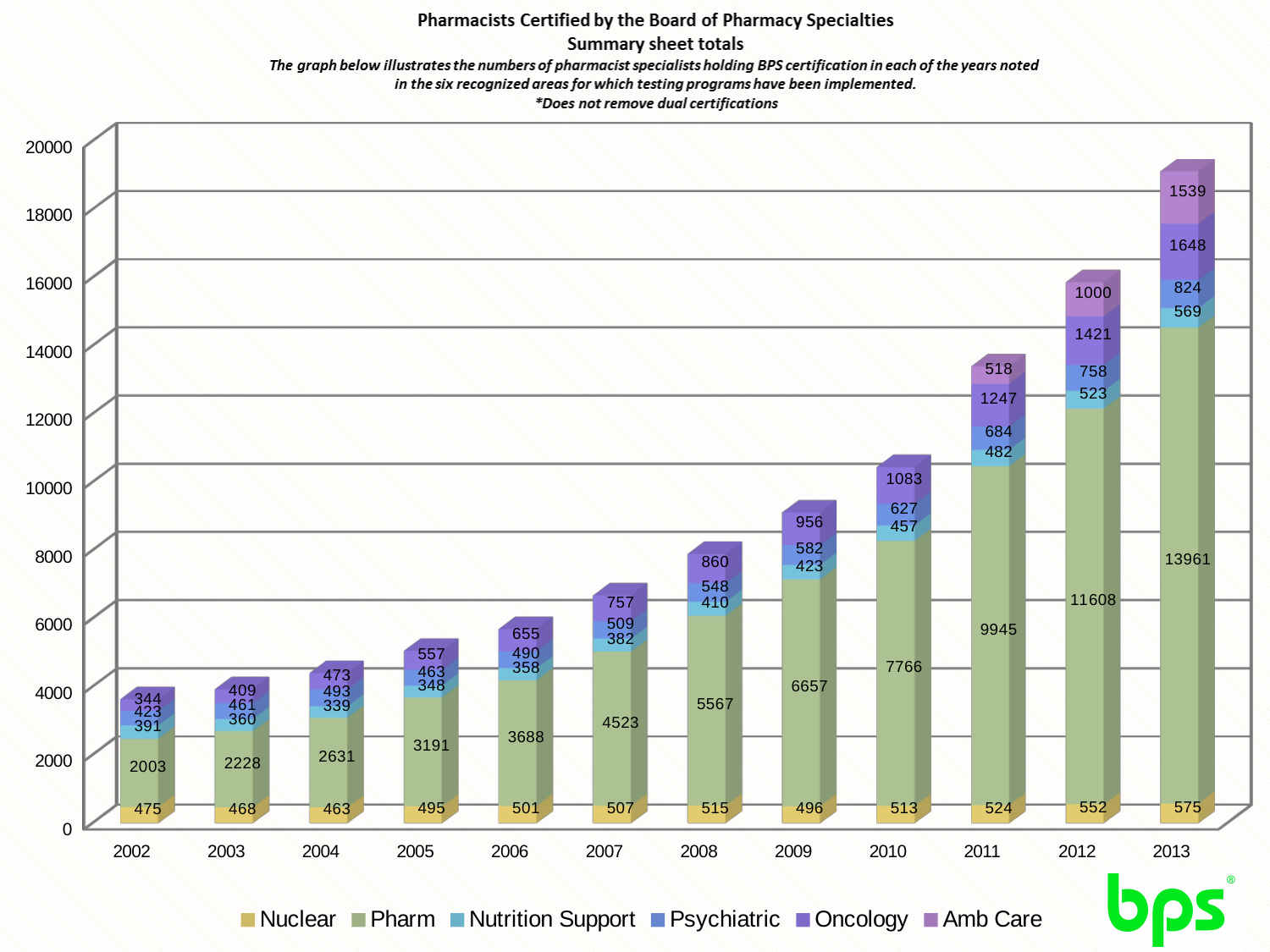
Do the Oncology values rise or fall from 2002 to 2013? Rise What is the difference between the Pharm values for 2013 and 2012? 2353 How many years are shown on the x axis? 12 What kind of chart is this? Stacked bar chart What is the value for Amb Care in 2011? 518 Which year has the lowest Nuclear value? 2004 How many series does the legend list? 6 What is the value for Oncology in 2008? 860 Which is larger, the Psychiatric value in 2010 or the Nutrition Support value in 2010? Psychiatric Which year has the highest Pharm value? 2013 What is the total of the stacked bar for 2002? 3636 What is the value for Pharm in 2013? 13961